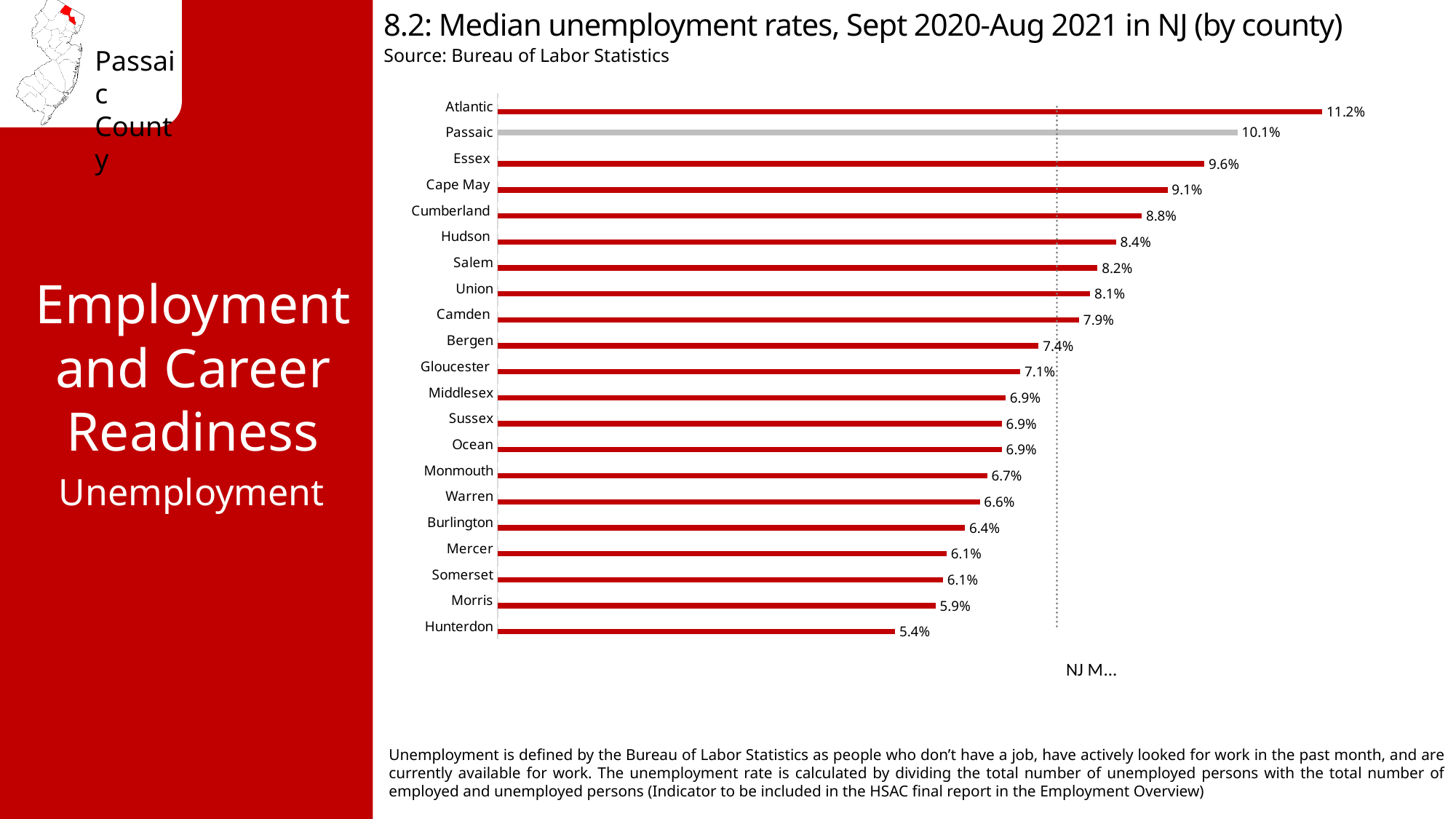
What is the difference between the median unemployment rates of Bergen and Morris counties? 1.5% Which county has the lowest median unemployment rate? Hunterdon Which county's bar is coloured grey instead of red? Passaic What is the title of the chart? 8.2: Median unemployment rates, Sept 2020-Aug 2021 in NJ (by county) What is the median unemployment rate for Hudson county? 8.4% How many counties are shown in the chart? 21 What is the median unemployment rate for Passaic county? 10.1% What is the difference between the median unemployment rates of Atlantic and Passaic counties? 1.1% What is the median unemployment rate for Hunterdon county? 5.4% What kind of chart is used to show the median unemployment rates? Bar chart Which county has the highest median unemployment rate? Atlantic Which county has a higher median unemployment rate, Essex or Cape May? Essex